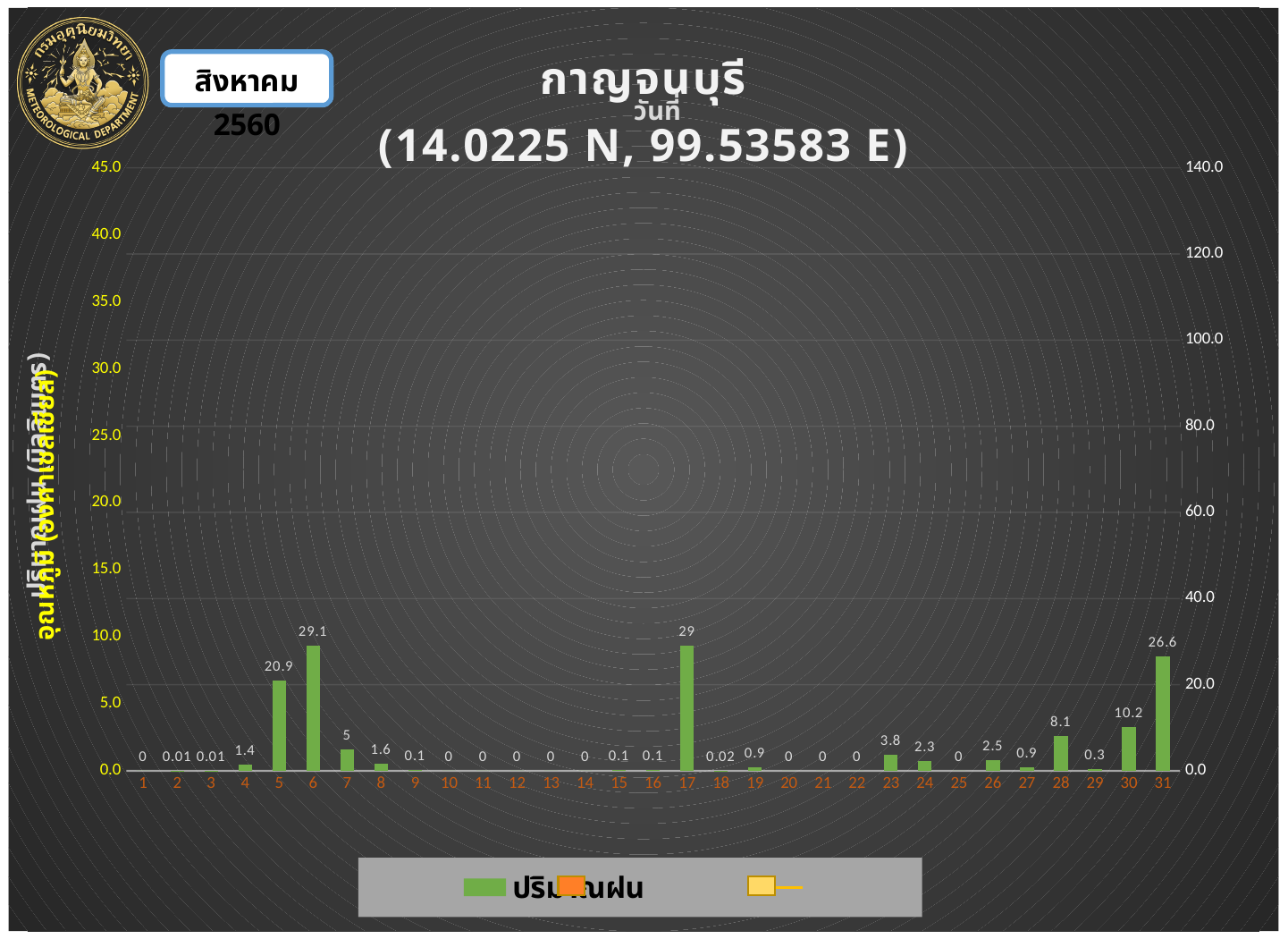
Which day has the highest rainfall value? 6 What is the difference between the rainfall values for day 31 and day 30? 16.4 How many days are shown on the x axis? 31 What is the rainfall value shown for day 31? 26.6 What kind of chart is used to show the rainfall values? bar chart What is the difference between the rainfall values for day 6 and day 17? 0.1 What is the rainfall value shown for day 5? 20.9 Which day has the larger rainfall value, day 23 or day 24? 23 Which day has the larger rainfall value, day 7 or day 8? 7 What coordinates are given in the chart title? 14.0225 N, 99.53583 E What is the rainfall value shown for day 28? 8.1 What is the rainfall value shown for day 18? 0.02